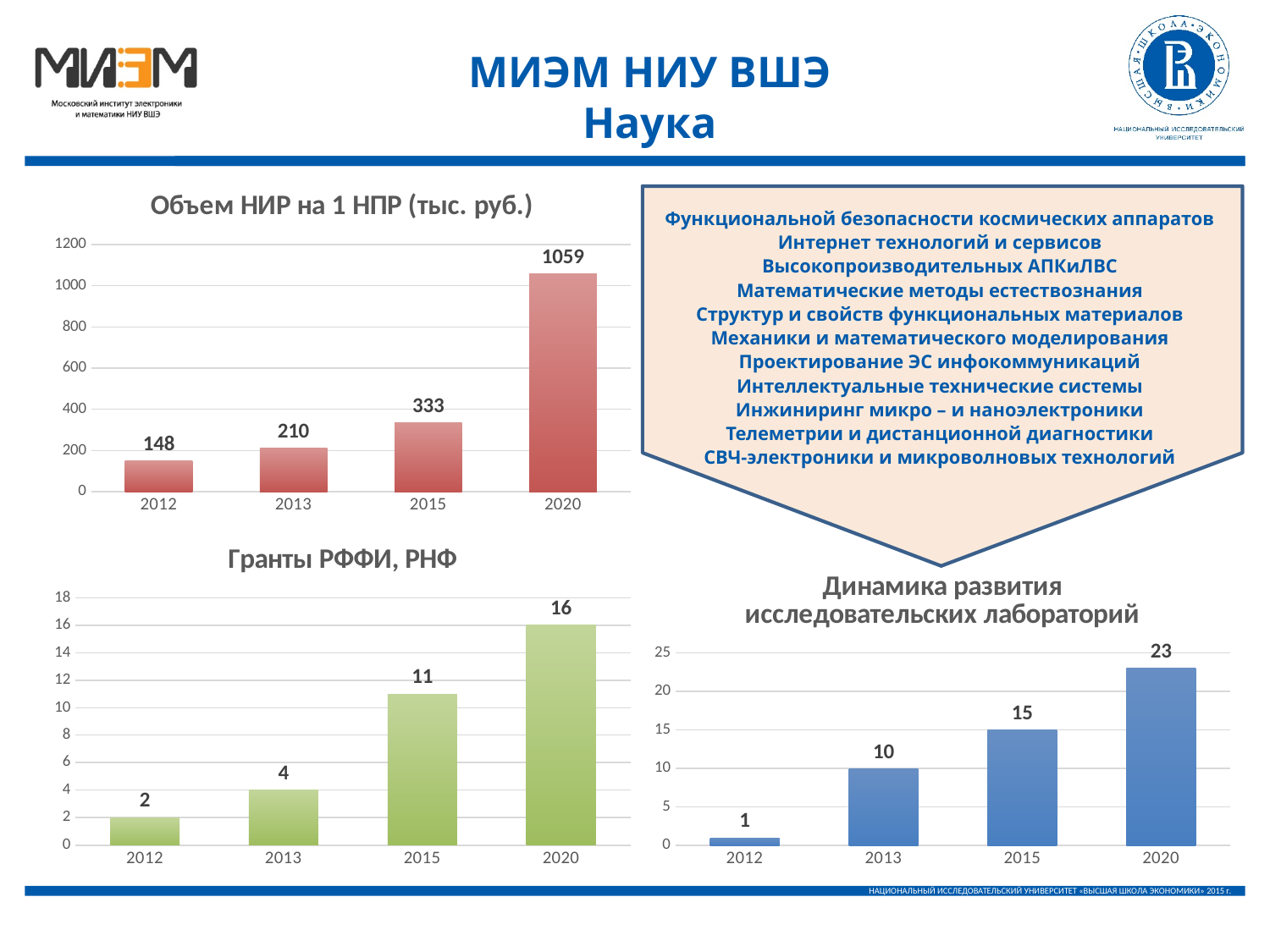
In the chart titled "Объем НИР на 1 НПР (тыс. руб.)", which year has the highest value? 2020 In the chart titled "Объем НИР на 1 НПР (тыс. руб.)", what is the difference between the values for 2020 and 2012? 911 In the chart titled "Динамика развития исследовательских лабораторий", what is the difference between the values for 2020 and 2012? 22 In the chart titled "Гранты РФФИ, РНФ", what is the value for 2013? 4 In the chart titled "Объем НИР на 1 НПР (тыс. руб.)", what is the value for 2015? 333 What kind of chart is the chart titled "Динамика развития исследовательских лабораторий"? bar chart In the chart titled "Динамика развития исследовательских лабораторий", which is larger, the value for 2013 or the value for 2020? 2020 In the chart titled "Объем НИР на 1 НПР (тыс. руб.)", how many years are shown on the x axis? 4 In the chart titled "Динамика развития исследовательских лабораторий", what is the value for 2015? 15 In the chart titled "Гранты РФФИ, РНФ", what is the difference between the values for 2020 and 2015? 5 In the chart titled "Гранты РФФИ, РНФ", which year has the lowest value? 2012 In the chart titled "Гранты РФФИ, РНФ", do the values rise or fall from 2012 to 2020? rise